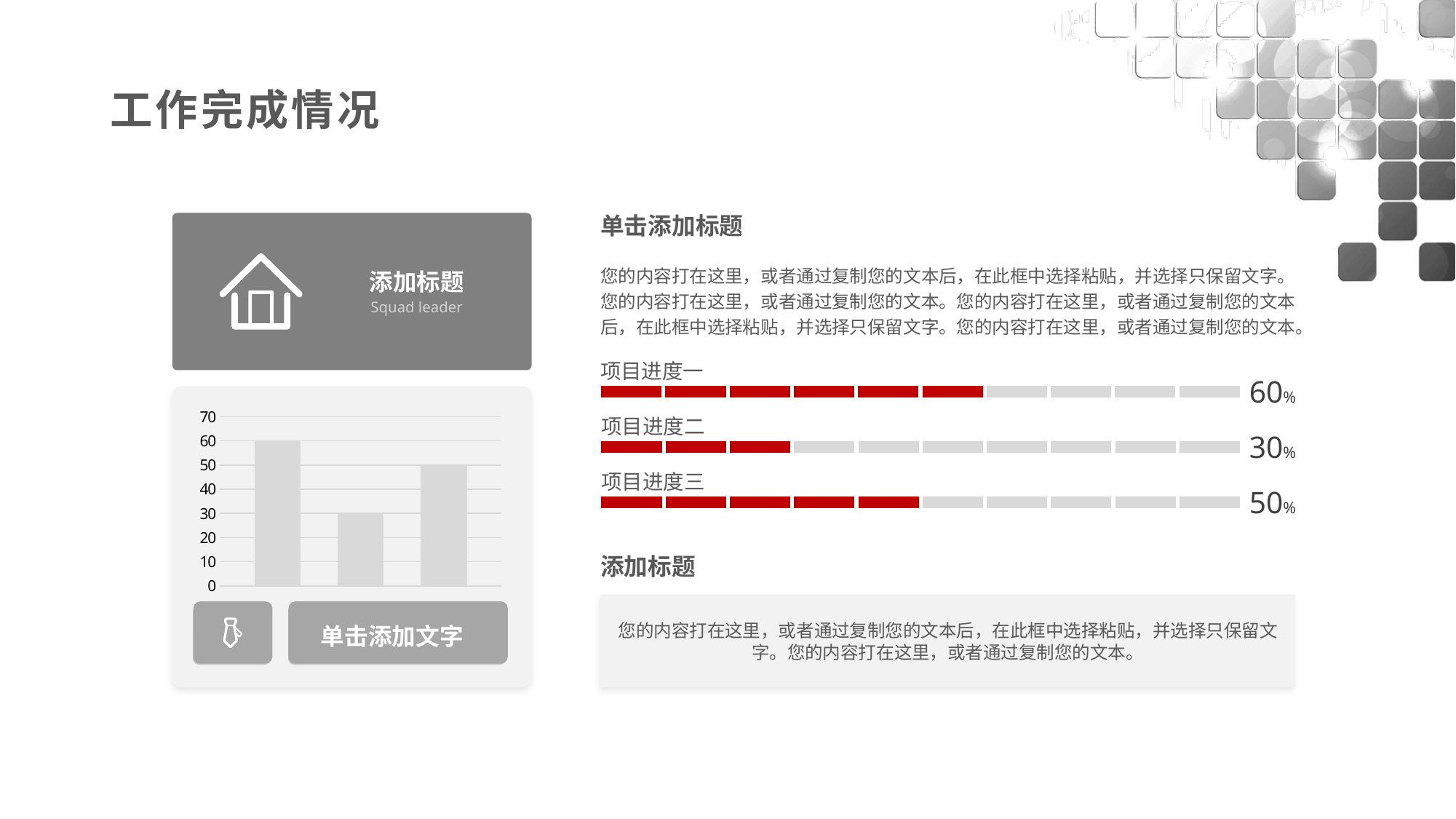
In the bar chart on the left, which bar is the shortest? the second (middle) bar In the bar chart on the left, which bar is the tallest? the first (leftmost) bar What is the highest value shown on the vertical axis of the bar chart on the left? 70 In the bar chart on the left, which is larger: the second bar or the third bar? the third bar In the bar chart on the left, is the value of the first bar greater or less than 40? greater In the bar chart on the left, what value does the first (leftmost) bar reach? 60 In the bar chart on the left, what is the difference between the first bar and the second bar? 30 What kind of chart is shown on the left of the slide? bar chart How many bars does the bar chart on the left show? 3 In the bar chart on the left, what value does the third (rightmost) bar reach? 50 In the bar chart on the left, what value does the second (middle) bar reach? 30 In the bar chart on the left, do the bar values rise or fall from the first bar to the second bar? fall